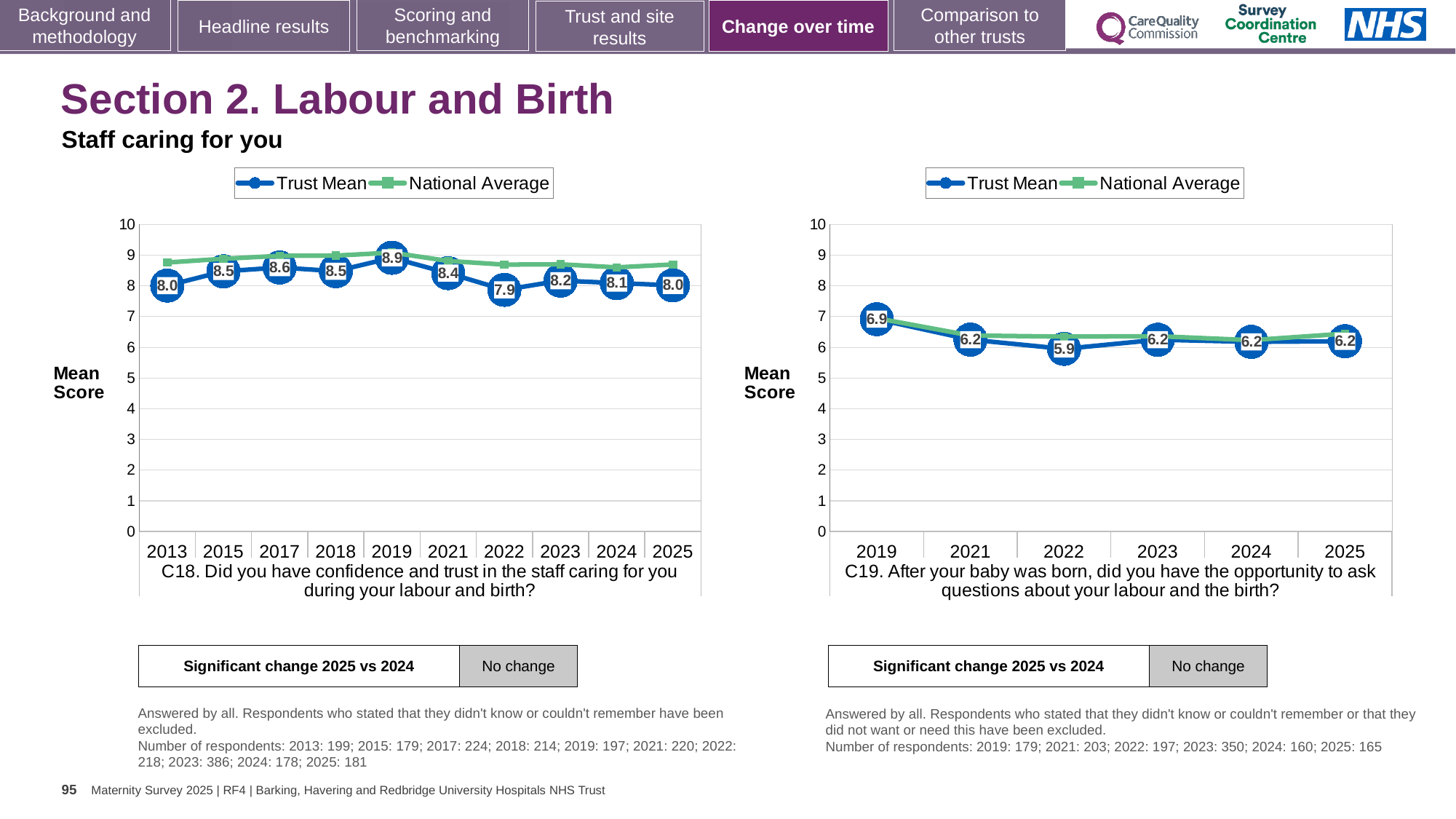
How many years are plotted on the x axis of the C18 chart? 10 What kind of chart is the C18 chart? Line chart In the C18 chart, what is the Trust Mean score for 2022? 7.9 In the C18 chart, what is the Trust Mean score for 2019? 8.9 In the C19 chart, is the Trust Mean score for 2019 larger or smaller than the Trust Mean score for 2025? larger In the C18 chart, what is the difference between the Trust Mean scores for 2019 and 2025? 0.9 In the C18 chart, which year has the lowest Trust Mean score? 2022 In the C19 chart, which year has the lowest Trust Mean score? 2022 In the C19 chart, is the National Average value for 2019 greater or less than 8? less In the C19 chart, what is the Trust Mean score for 2019? 6.9 How many series does the legend of the C19 chart list? 2 In the C18 chart, which year has the highest Trust Mean score? 2019